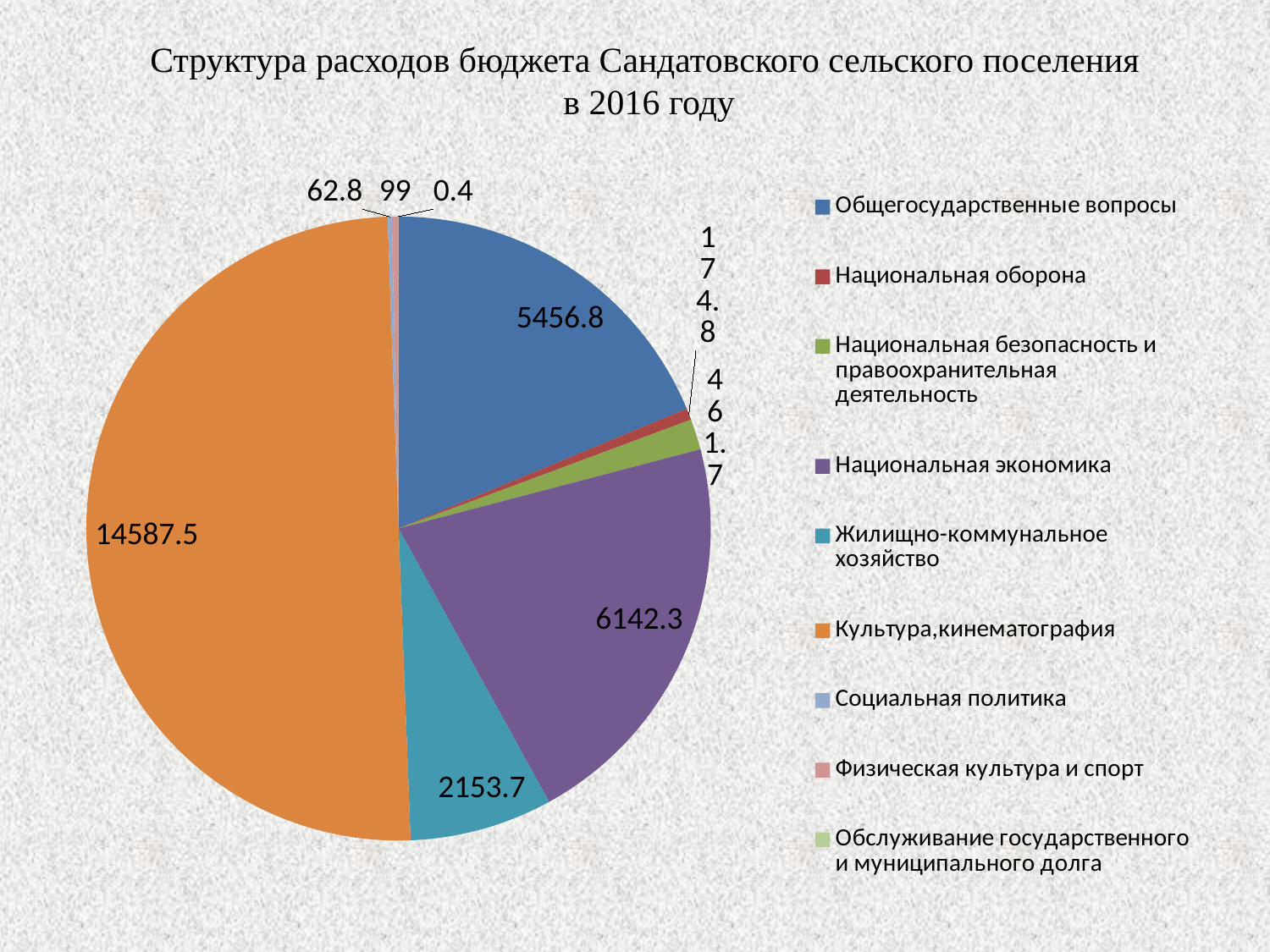
Which category has the smallest value? Обслуживание государственного и муниципального долга What is the value for Социальная политика? 62.8 Which category has the largest slice of the pie? Культура,кинематография How many categories does the legend list? 9 What is the value for Культура,кинематография? 14587.5 What is the title of the chart? Структура расходов бюджета Сандатовского сельского поселения в 2016 году What is the value for Жилищно-коммунальное хозяйство? 2153.7 Which is larger: the value for Национальная экономика or the value for Общегосударственные вопросы? Национальная экономика What is the value for Национальная экономика? 6142.3 What is the difference between the values for Национальная экономика and Общегосударственные вопросы? 685.5 What is the value for Общегосударственные вопросы? 5456.8 What kind of chart is shown on the slide? pie chart